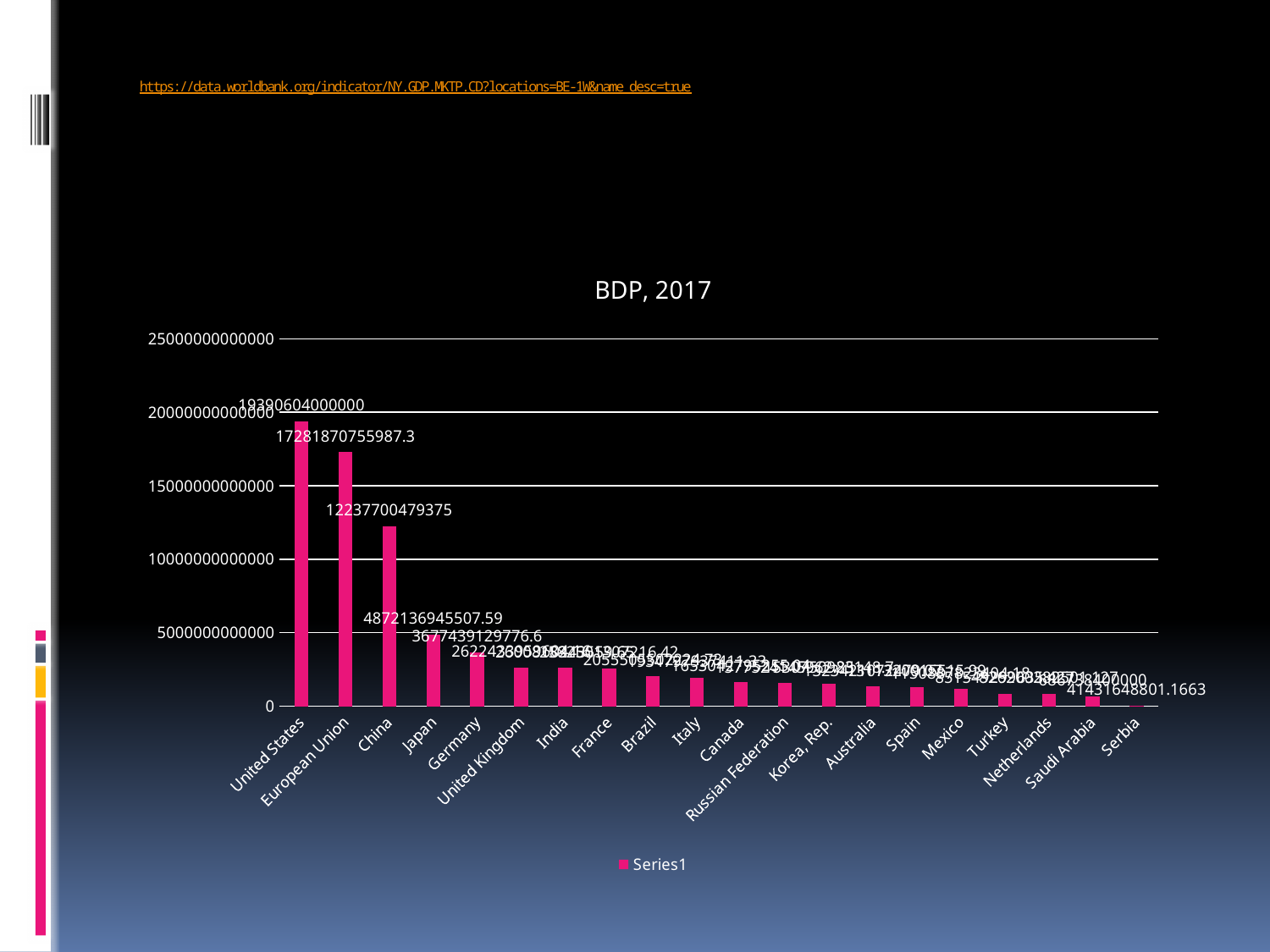
Which category has the highest value? United States What is the title of the chart? BDP, 2017 What is the value for Serbia? 41431648801.1663 Is the value for United Kingdom greater or less than 5000000000000? less What is the value for Japan? 4872136945507.59 What type of chart is shown on the slide? bar chart How many categories are plotted on the x axis of the chart? 20 What is the value for United States? 19390604000000 How many series does the legend list? 1 Which is larger, the value for China or the value for Japan? China What is the value for China? 12237700479375 Which category has the lowest value? Serbia